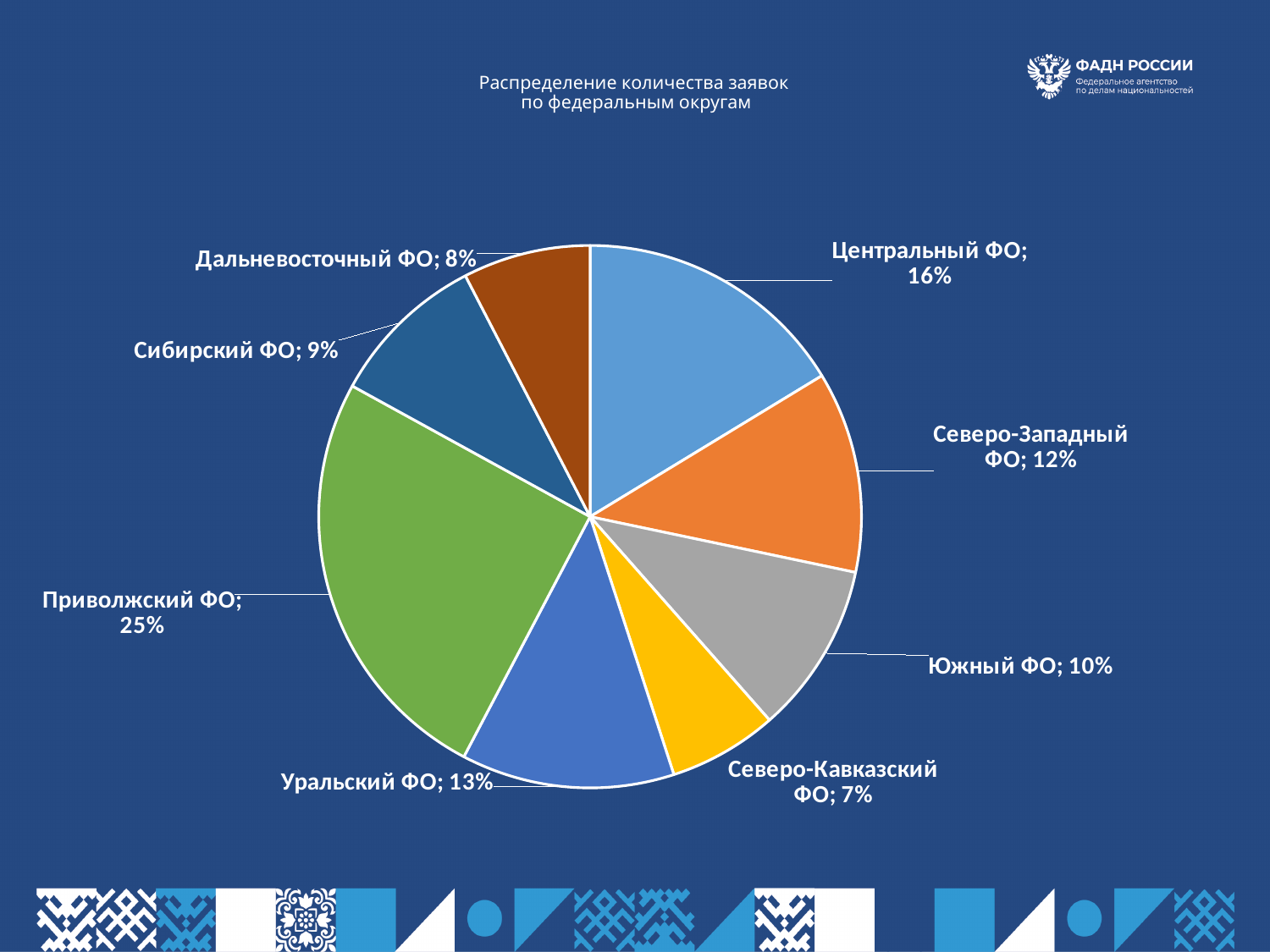
What is the title of the chart? Распределение количества заявок по федеральным округам What colour is the slice for Приволжский ФО? Green What is the difference between the shares of Приволжский ФО and Уральский ФО? 12% How many federal districts are shown in the pie chart? 8 What share of applications does Приволжский ФО account for? 25% What is the difference between the shares of Сибирский ФО and Дальневосточный ФО? 1% What kind of chart is shown on the slide? Pie chart Which has a larger share, Северо-Западный ФО or Южный ФО? Северо-Западный ФО What is the value shown for Центральный ФО? 16% What is the value shown for Северо-Кавказский ФО? 7% Which federal district has the largest share of applications? Приволжский ФО Which federal district has the smallest share of applications? Северо-Кавказский ФО